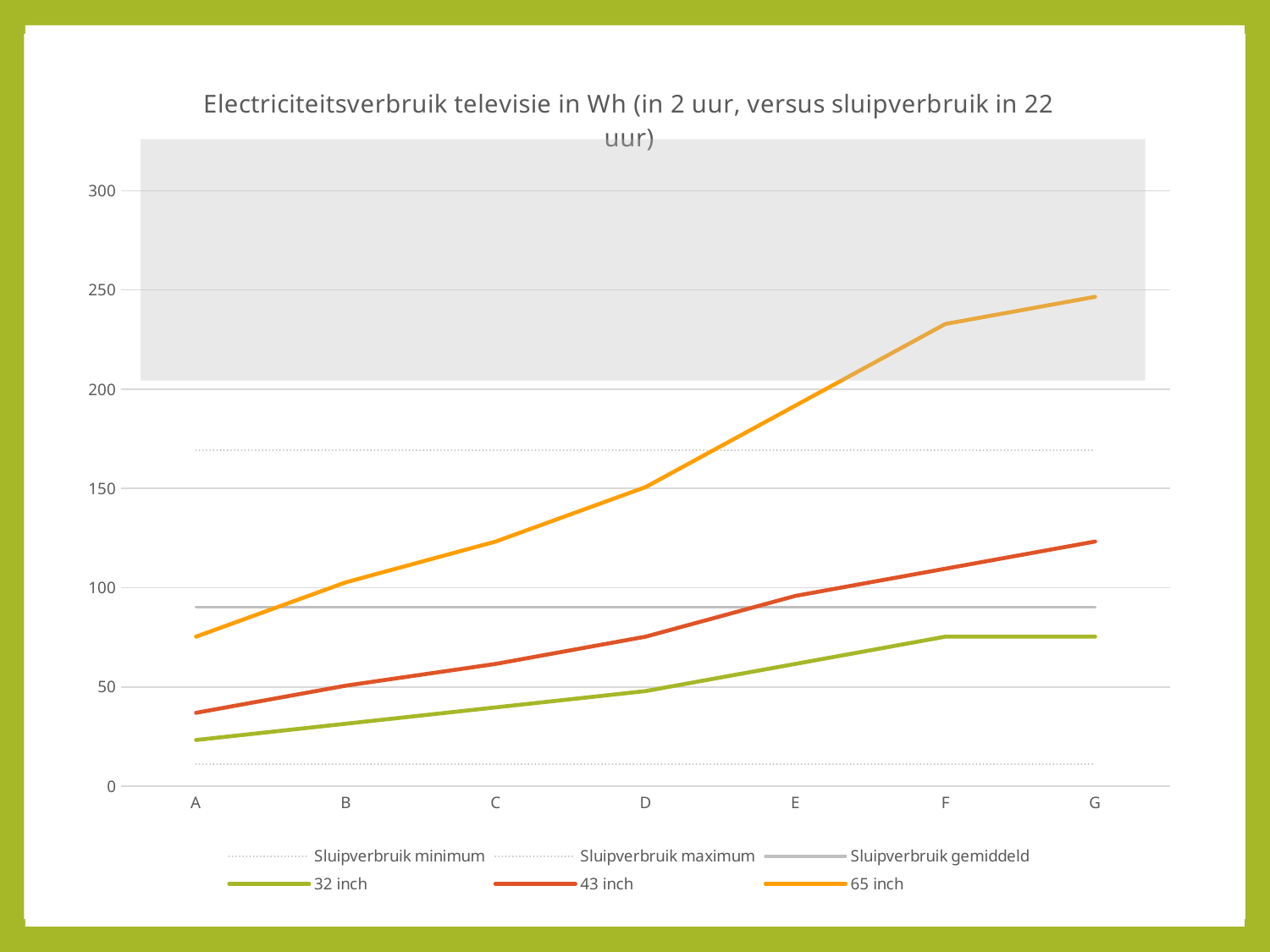
At category D, which is larger: the 65 inch value or the 32 inch value? 65 inch What is the title of the chart? Electriciteitsverbruik televisie in Wh (in 2 uur, versus sluipverbruik in 22 uur) What kind of chart is shown on the slide? line chart How many categories are shown on the x axis? 7 Is the value for 65 inch at category A greater or less than 100? less For the 65 inch series, which category has the highest value? G Is the value for 43 inch at category G greater or less than 100? greater How many series does the legend list? 6 Is the value for 32 inch at category G greater or less than 100? less For the 43 inch series, which category has the lowest value? A